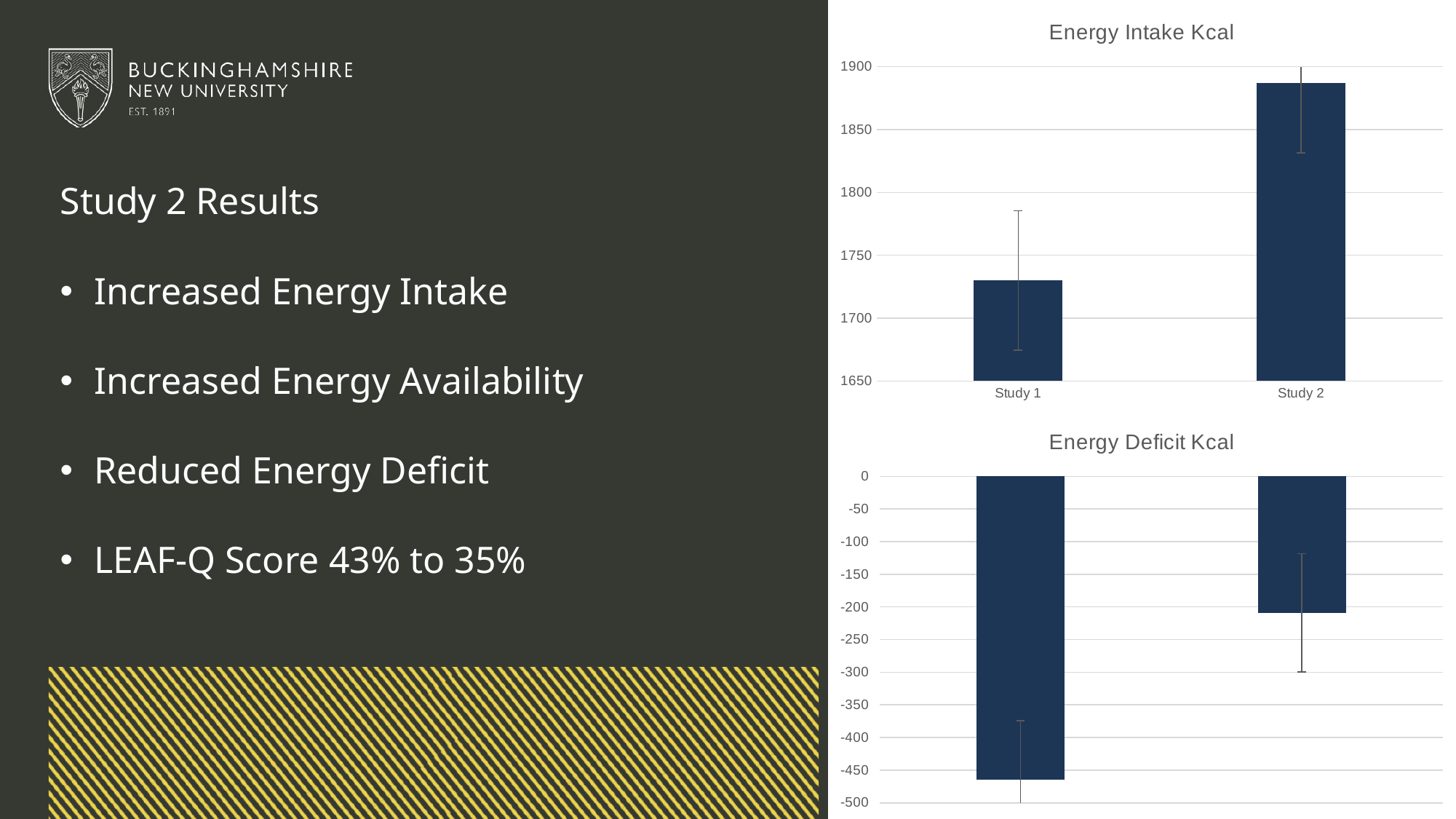
In the Energy Intake Kcal chart, which study has the higher energy intake? Study 2 In the Energy Intake Kcal chart, is the value for Study 2 greater or less than 1850? greater What is the title of the top chart on the slide? Energy Intake Kcal In the Energy Deficit Kcal chart, is the value for Study 1 greater or less than -400? less In the Energy Deficit Kcal chart, which study has the lowest (most negative) value? Study 1 How many categories are shown in the Energy Intake Kcal chart? 2 In the Energy Deficit Kcal chart, is the value for Study 2 greater or less than -250? greater What kind of chart is the Energy Deficit Kcal chart? bar chart In the Energy Deficit Kcal chart, which study has the larger value, Study 1 or Study 2? Study 2 In the Energy Intake Kcal chart, which study has the lower energy intake? Study 1